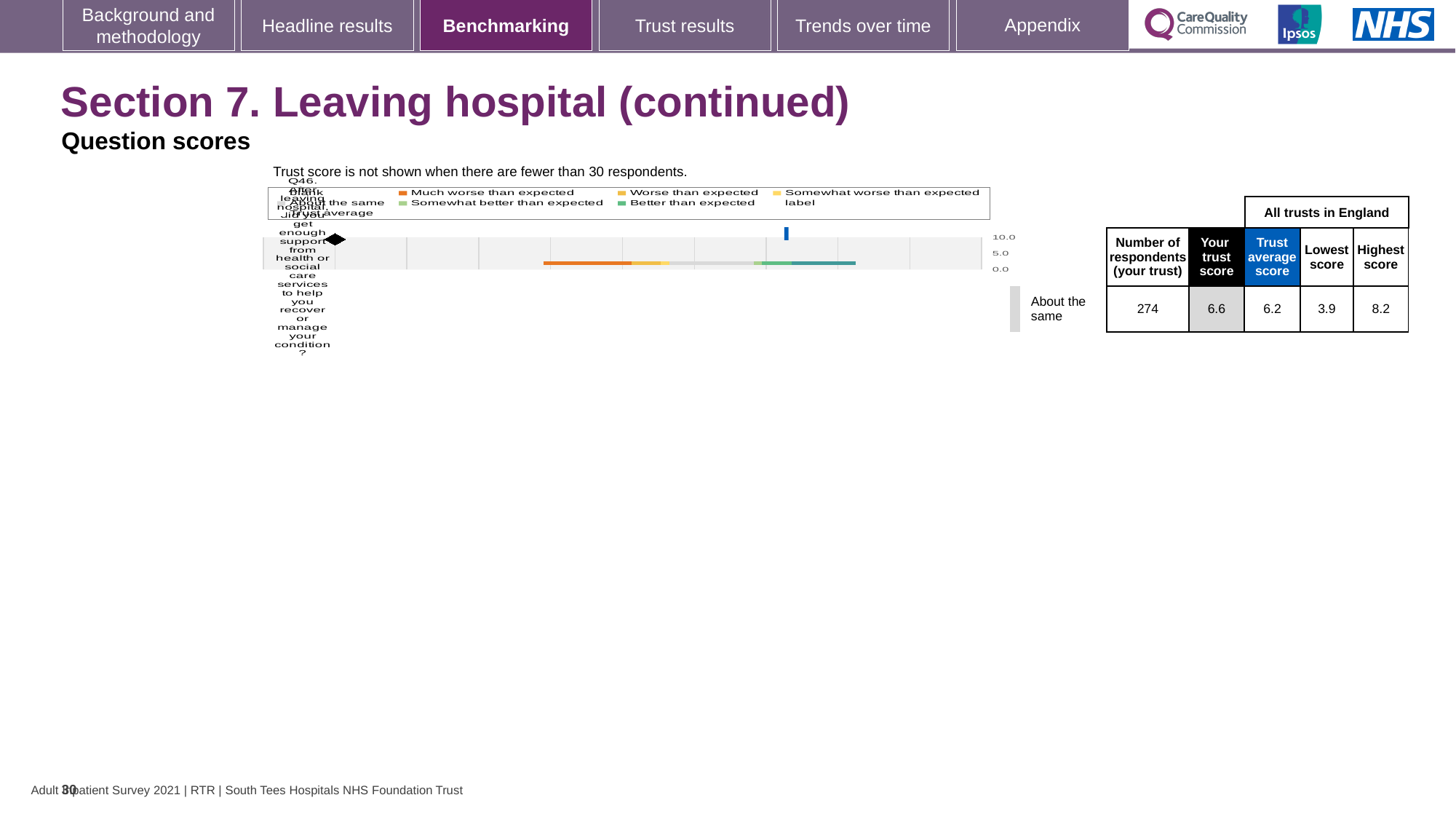
By how much does the trust score for Q46 exceed the trust average score? 0.4 What is the trust average score for Q46 across all trusts in England? 6.2 How many respondents from the trust answered Q46? 274 What kind of chart is used to show the Q46 score? Bar chart How many questions are plotted on the chart? 1 Is the trust score for Q46 greater or less than 5.0 on the chart axis? greater Which is larger for Q46: the trust score or the trust average score? Trust score What is the lowest score among all trusts in England for Q46? 3.9 What is the highest score among all trusts in England for Q46? 8.2 What is the difference between the highest and lowest scores for Q46 across all trusts in England? 4.3 What is the trust score for Q46 (support from health or social care services after leaving hospital)? 6.6 Which benchmark category is the trust's Q46 score placed in? About the same